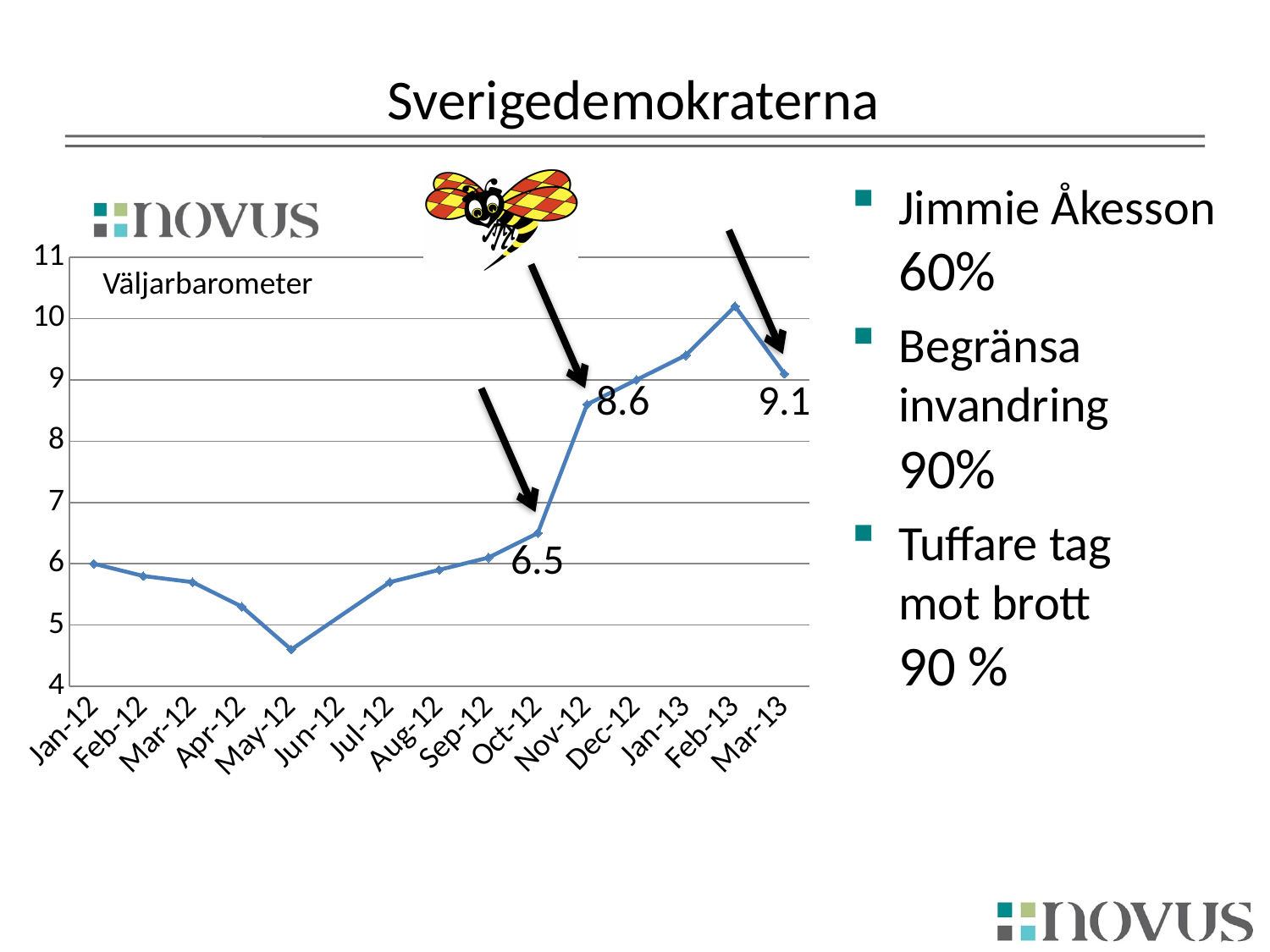
What is the difference between the values for Nov-12 and Oct-12? 2.1 What is the value for Mar-13 in the Väljarbarometer chart? 9.1 Is the value for Feb-13 greater or less than 10? greater Which month has the lowest value in the chart? May-12 What type of chart is shown on the slide? line chart How many months are plotted on the x axis of the chart? 15 What is the difference between the values for Mar-13 and Nov-12? 0.5 What is the value for Nov-12 in the Väljarbarometer chart? 8.6 What is the value for Oct-12 in the Väljarbarometer chart? 6.5 Is the value for May-12 greater or less than 5? less Which is larger, the value for Mar-13 or the value for Oct-12? Mar-13 Which month has the highest value in the chart? Feb-13